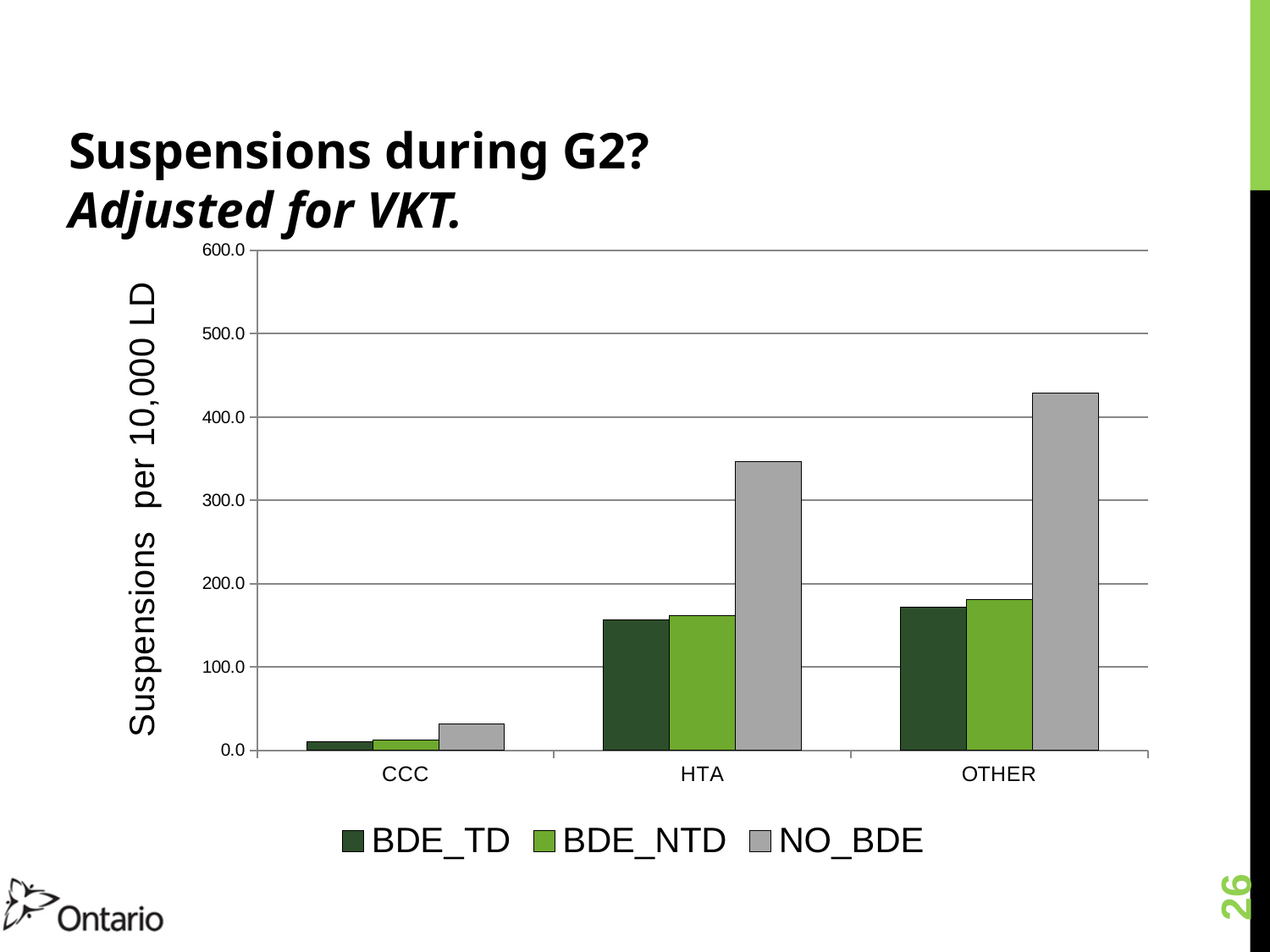
Which is larger, the NO_BDE value for HTA or the NO_BDE value for OTHER? OTHER How many categories are shown on the x axis? 3 What is the title of the y axis? Suspensions per 10,000 LD How many series does the legend list? 3 What kind of chart is shown on the slide? bar chart Is the BDE_TD value for HTA greater or less than 200? less Is the NO_BDE value for OTHER greater or less than 400? greater Is the NO_BDE value for HTA greater or less than 300? greater Do the NO_BDE values rise or fall from CCC to OTHER along the x axis? rise Which category has the highest NO_BDE value? OTHER Which category has the lowest NO_BDE value? CCC Within the OTHER category, which series has the larger value, BDE_TD or NO_BDE? NO_BDE